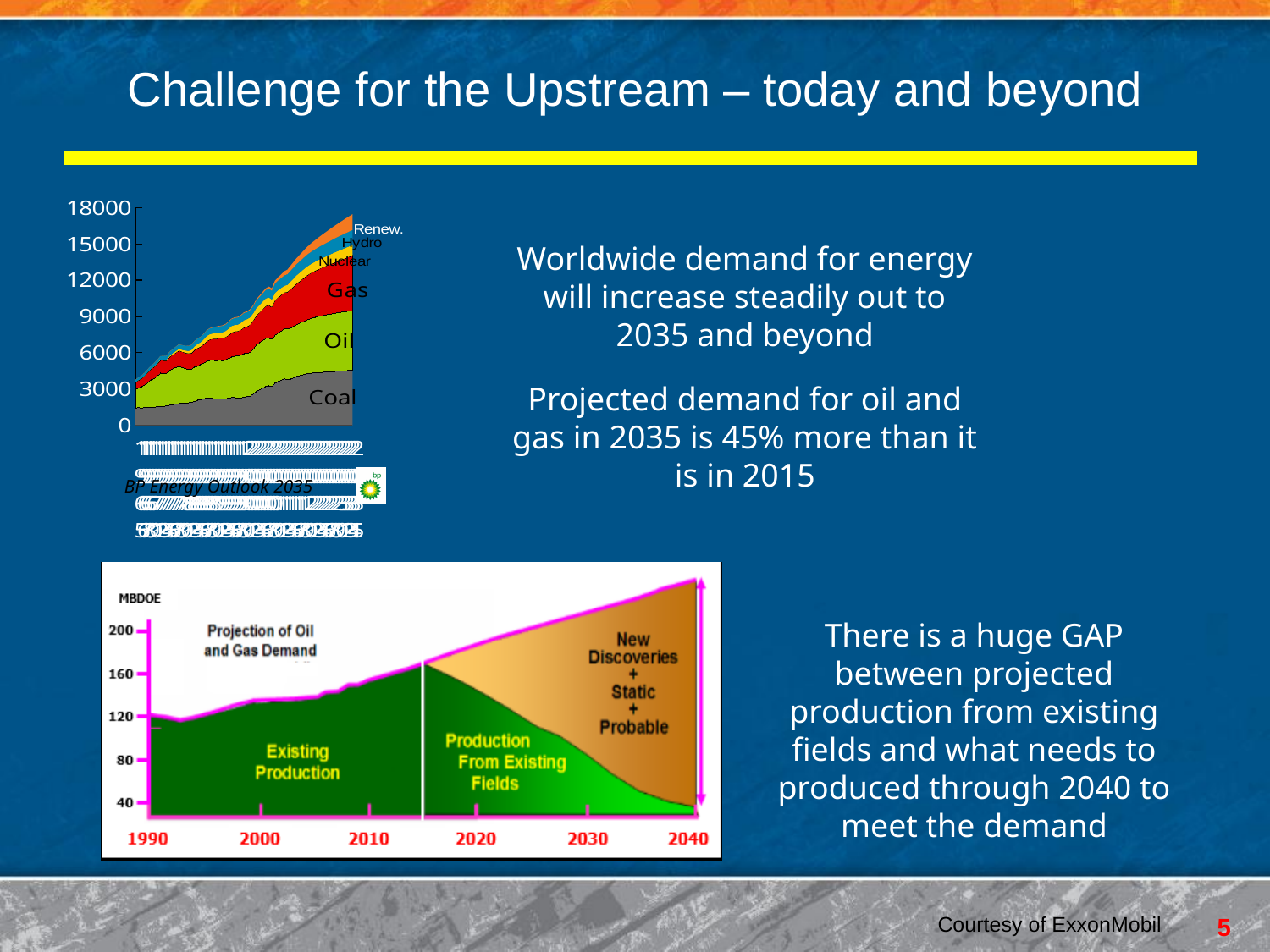
In the bottom chart (Projection of Oil and Gas Demand), does projected demand rise or fall from 1990 to 2040? Rise In the top-left chart, which energy source forms the top layer of the stack? Renew. In the top-left chart, is the total energy demand at the right end of the chart greater or less than 15000? greater In the top-left chart, does total energy demand rise or fall over time? Rise How many energy sources are labelled in the top-left stacked area chart? 6 In the bottom chart (Projection of Oil and Gas Demand), is production from existing fields in 2040 greater or less than 80? less In the top-left chart, which energy source forms the bottom layer of the stack? Coal In the top-left chart, is the total energy demand at the left end of the chart greater or less than 6000? less In the bottom chart (Projection of Oil and Gas Demand), what unit is shown on the y axis? MBDOE What is the highest value shown on the y axis of the top-left chart? 18000 What kind of chart is the top-left chart on the slide? Stacked area chart